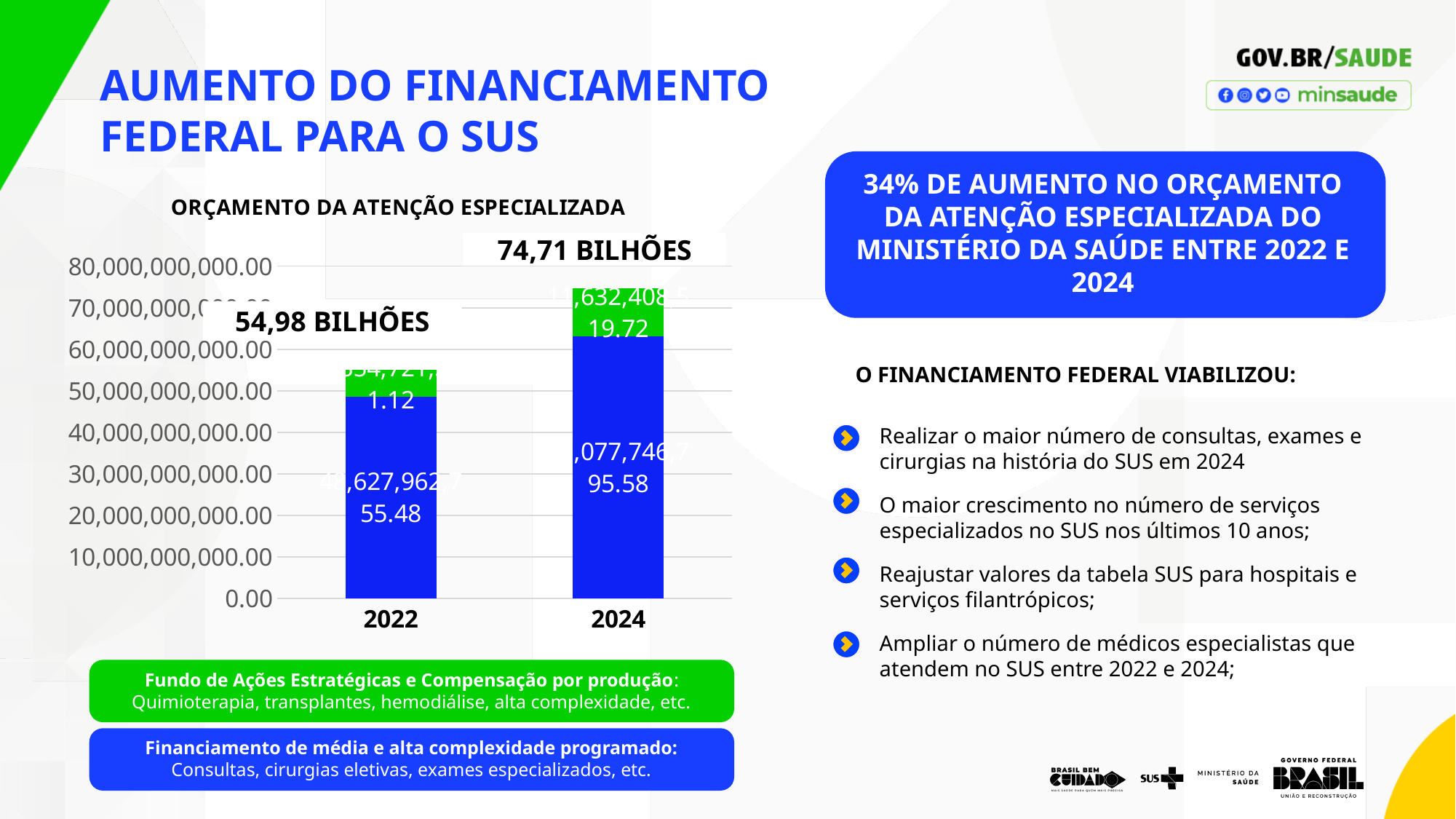
Which year has the taller bar in the chart? 2024 What kind of chart is shown under the title 'ORÇAMENTO DA ATENÇÃO ESPECIALIZADA'? Stacked bar chart How many years (categories) are plotted on the x axis of the chart? 2 Do the bar totals rise or fall from 2022 to 2024? Rise By how many billions does the labelled 2024 total exceed the labelled 2022 total? 19,73 bilhões What total value is labelled above the 2024 bar? 74,71 BILHÕES What total value is labelled above the 2022 bar? 54,98 BILHÕES Is the total for 2022 larger or smaller than the total for 2024? Smaller Is the blue segment of the 2024 bar greater or less than 70,000,000,000.00? less What is the highest value shown on the chart's vertical axis? 80,000,000,000.00 Is the total value of the 2024 bar greater or less than 70,000,000,000.00? greater Which year has the shorter bar in the chart? 2022